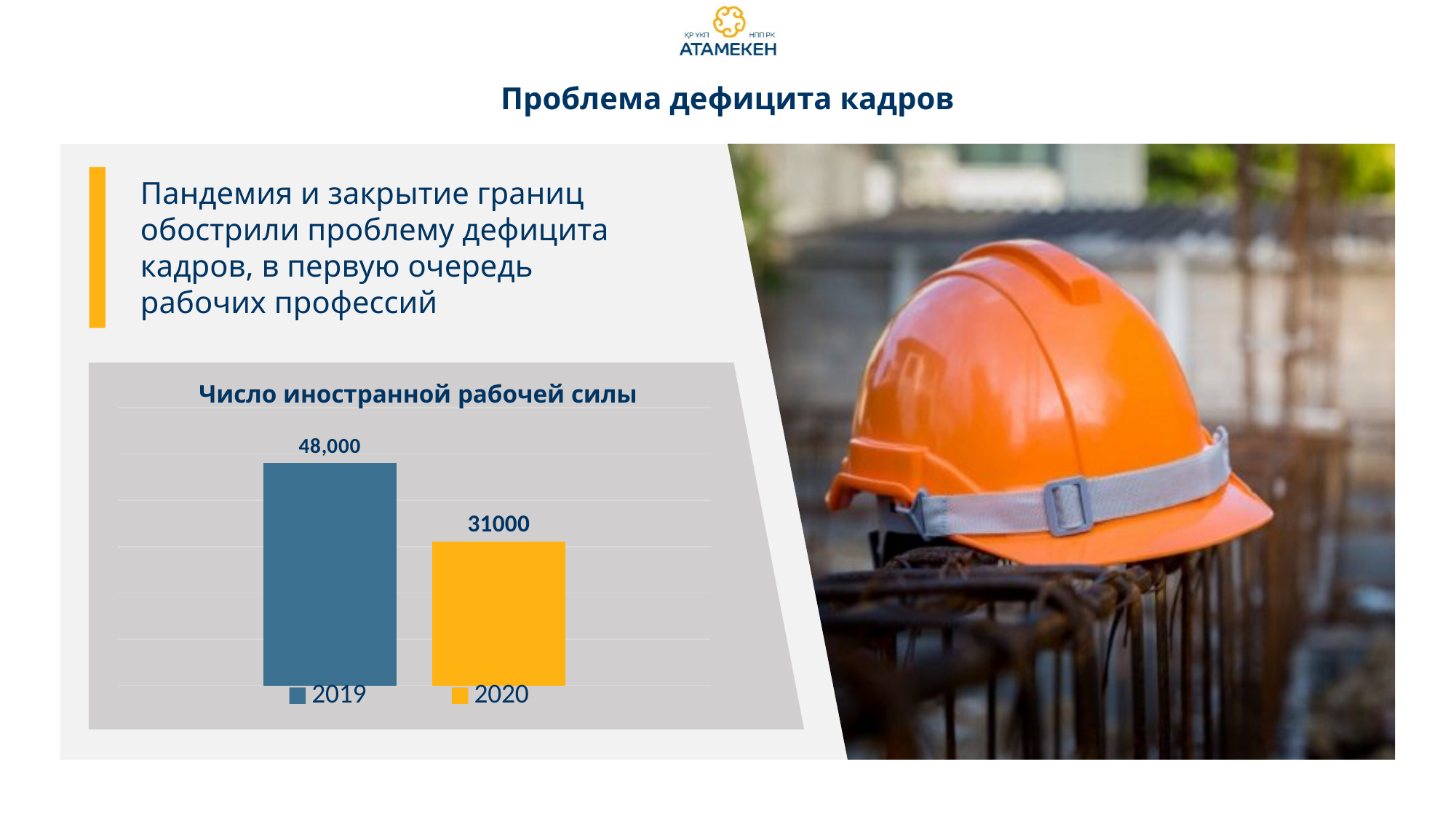
What is the value for 2020 in the chart 'Число иностранной рабочей силы'? 31000 Do the values rise or fall from 2019 to 2020 in the chart 'Число иностранной рабочей силы'? fall What is the difference between the 2019 and 2020 values in the chart 'Число иностранной рабочей силы'? 17,000 Which year has the higher value in the chart 'Число иностранной рабочей силы'? 2019 What is the value for 2019 in the chart 'Число иностранной рабочей силы'? 48,000 How many bars are plotted in the chart 'Число иностранной рабочей силы'? 2 What colour is the bar for 2020 in the chart 'Число иностранной рабочей силы'? yellow How many entries does the legend of the chart 'Число иностранной рабочей силы' list? 2 What is the title of the chart on the slide? Число иностранной рабочей силы What kind of chart is 'Число иностранной рабочей силы'? bar chart Is the value for 2020 larger or smaller than the value for 2019 in the chart 'Число иностранной рабочей силы'? smaller Which year has the lower value in the chart 'Число иностранной рабочей силы'? 2020